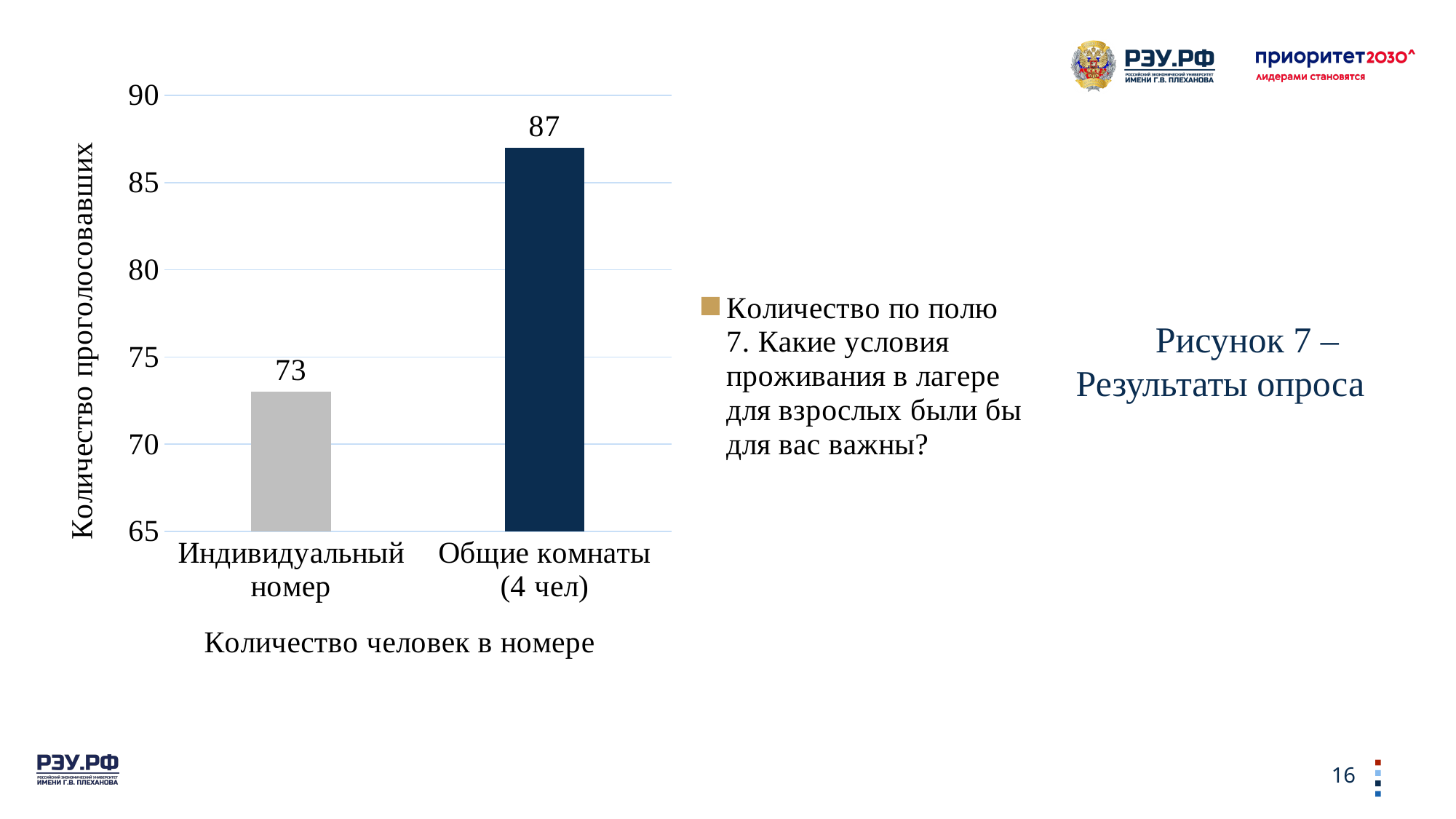
What kind of chart is shown? bar chart Which is larger: the value for Индивидуальный номер or for Общие комнаты (4 чел)? Общие комнаты (4 чел) What is the value for Индивидуальный номер? 73 How many categories are shown on the x axis? 2 What is the difference between the values for Общие комнаты (4 чел) and Индивидуальный номер? 14 What is the title of the y axis? Количество проголосовавших Which category has the lowest value? Индивидуальный номер Is the value for Индивидуальный номер greater or less than 75? less What is the value for Общие комнаты (4 чел)? 87 Is the value for Общие комнаты (4 чел) greater or less than 85? greater Which category has the highest value? Общие комнаты (4 чел) How many series does the legend list? 1